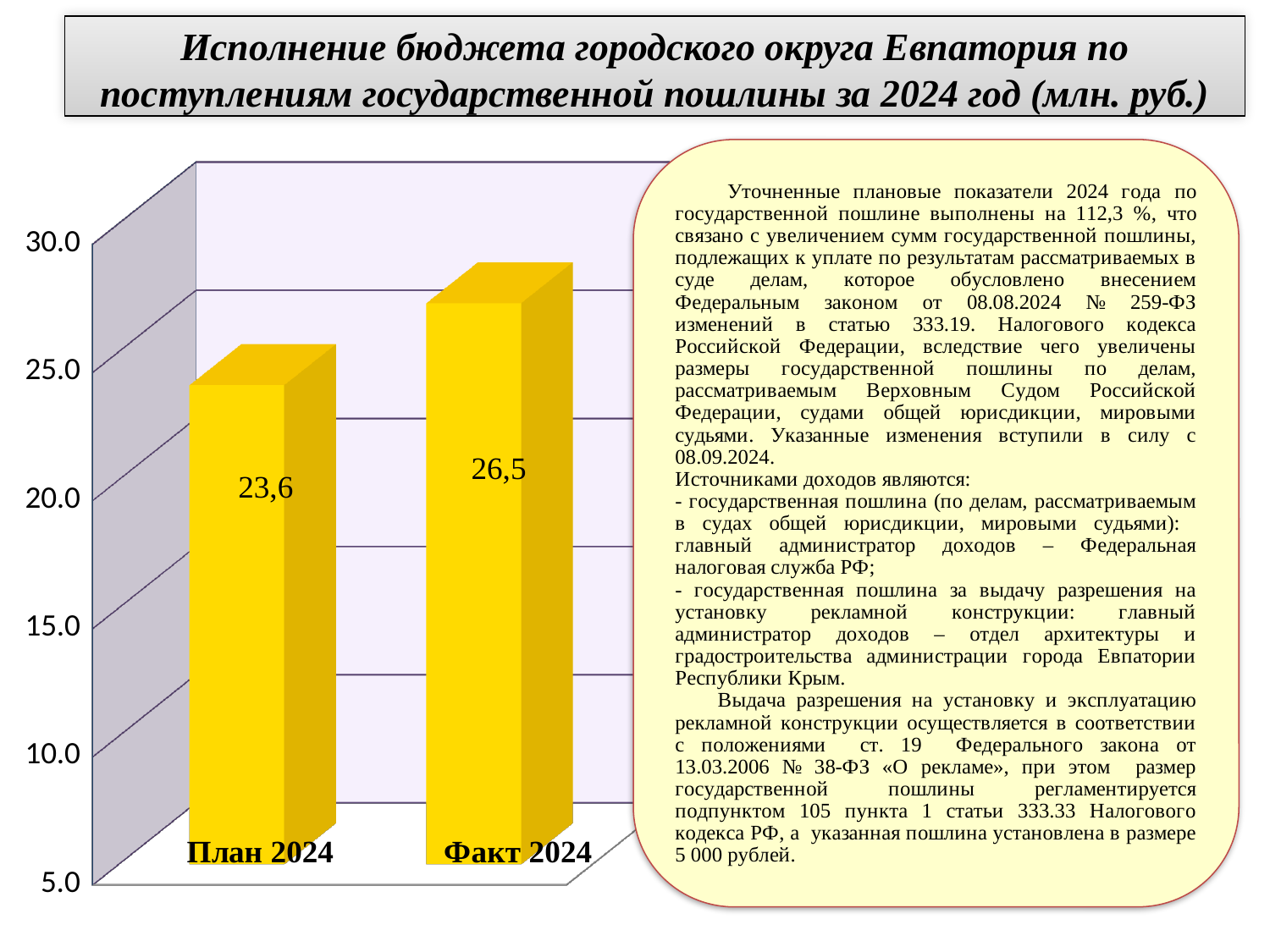
Is the value for Факт 2024 greater or less than 25.0? greater Which category has the lowest value? План 2024 What unit is given in the slide title for the chart values? млн. руб. What is the value for Факт 2024? 26,5 Do the values rise or fall from План 2024 to Факт 2024? rise What kind of chart is shown on the slide? bar chart Which is larger, the value for План 2024 or the value for Факт 2024? Факт 2024 Is the value for План 2024 greater or less than 25.0? less What is the value for План 2024? 23,6 What is the difference between the values for Факт 2024 and План 2024? 2,9 Which category has the highest value? Факт 2024 How many categories are shown in the chart? 2